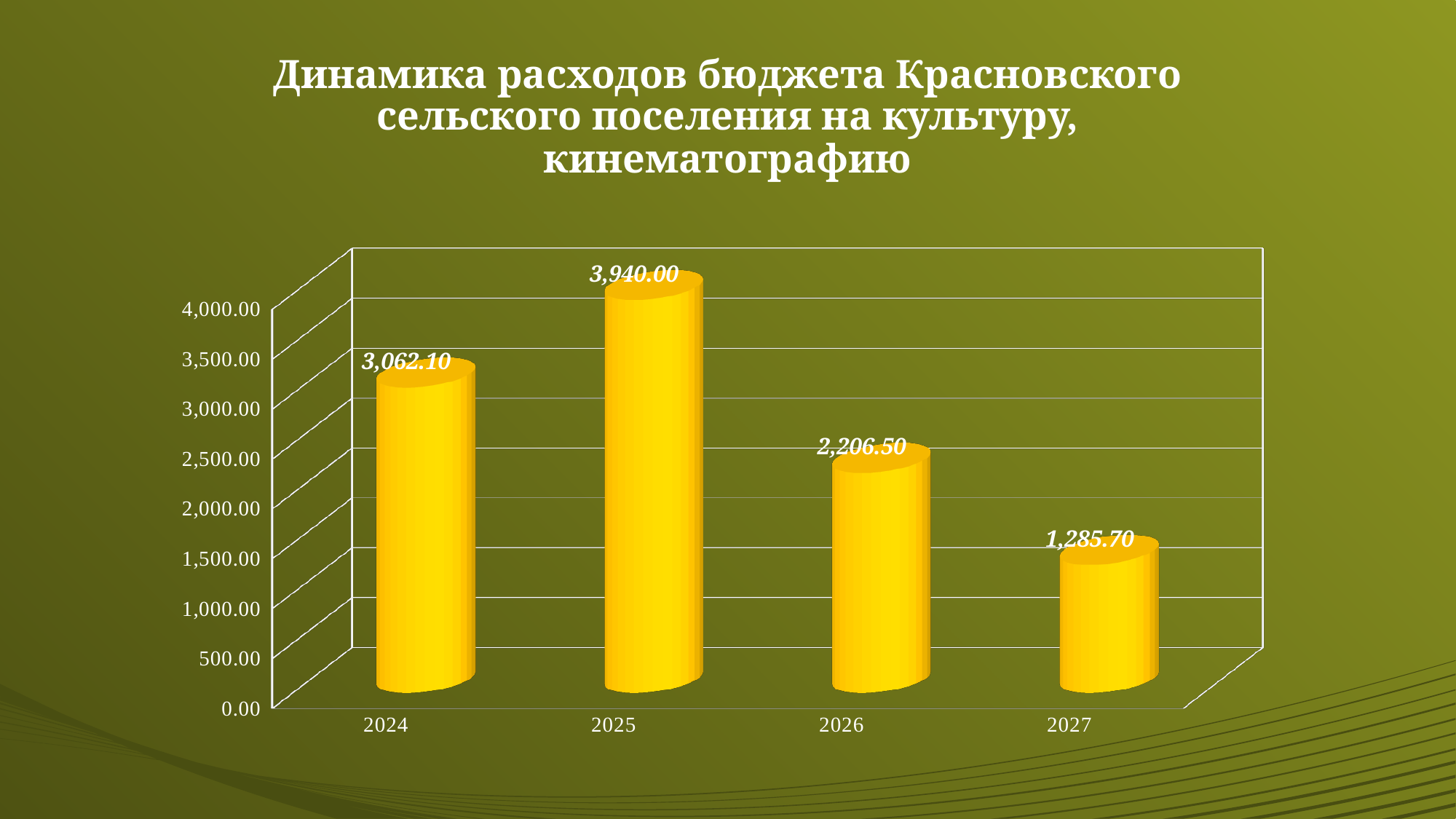
Which is larger, the value for 2024 or the value for 2026? 2024 What is the value for 2025? 3,940.00 What is the value for 2026? 2,206.50 Which year has the highest value? 2025 How many years are shown on the x axis? 4 What kind of chart is shown on the slide? bar chart What is the value for 2024? 3,062.10 What is the value for 2027? 1,285.70 Do the values rise or fall from 2025 to 2027? fall What is the difference between the values for 2025 and 2024? 877.90 What is the difference between the values for 2026 and 2027? 920.80 Which year has the lowest value? 2027